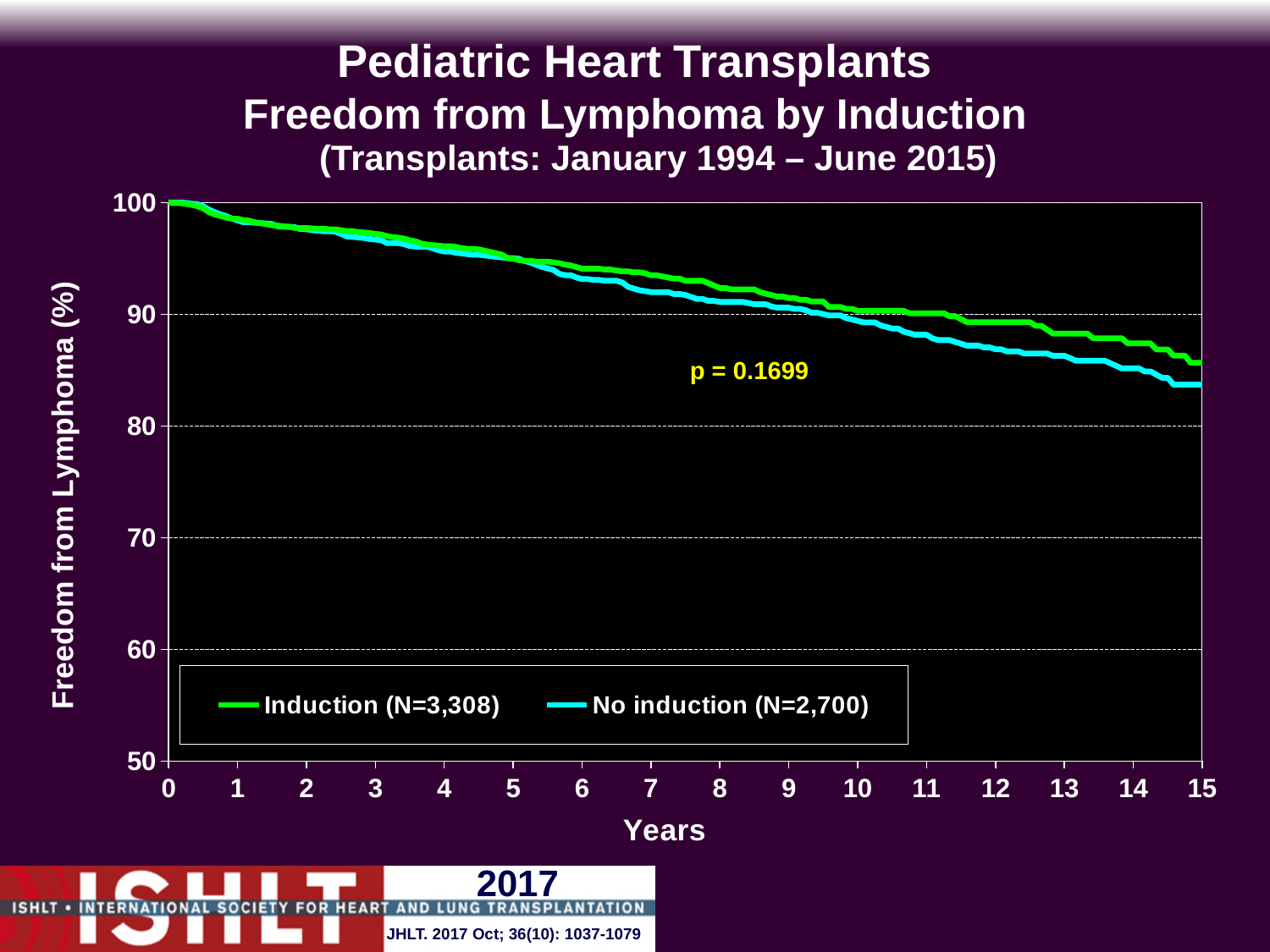
At 15 years, which series has the higher freedom from lymphoma, Induction or No induction? Induction Do the values for the Induction series rise or fall as the years increase? Fall Is the value for No induction at 15 years greater or less than 80? greater Is the value for Induction at 5 years greater or less than 90? greater Is the value for Induction at 15 years greater or less than 90? less What is the N for the Induction group shown in the legend? N=3,308 Do the values for the No induction series rise or fall along the x axis? Fall What kind of chart is shown on the slide? Line chart What p-value is printed on the chart? p = 0.1699 How many series does the legend list? 2